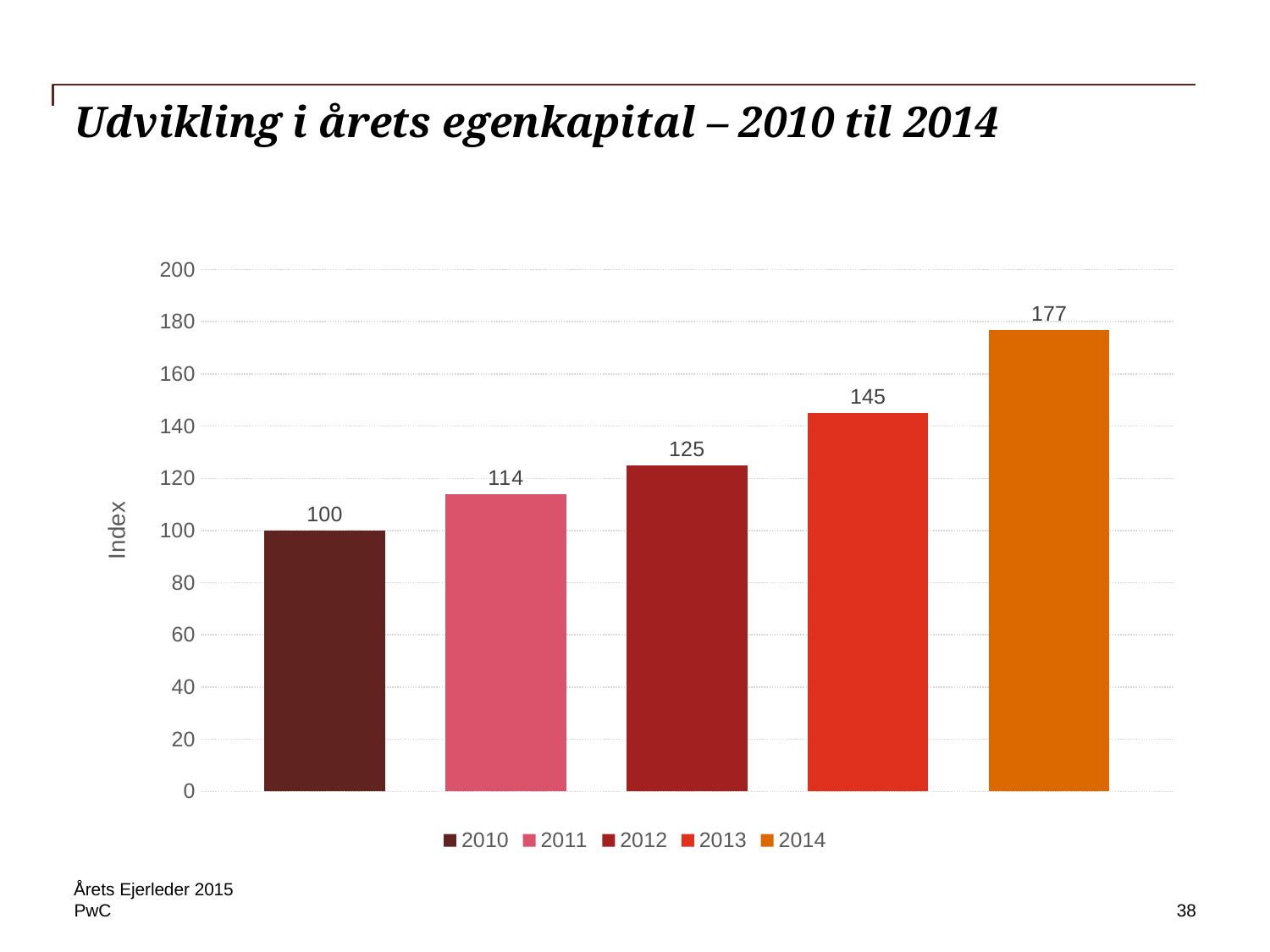
Do the index values rise or fall from 2010 to 2014? Rise What is the difference between the index values for 2014 and 2010? 77 Which is larger, the index value for 2012 or for 2011? 2012 What kind of chart is shown on the slide? Bar chart How many entries does the legend list? 5 What is the index value for 2011? 114 Which year has the highest index value? 2014 What is the index value for 2013? 145 What is the index value for 2014? 177 How many bars are shown in the chart? 5 Which year has the lowest index value? 2010 What is the difference between the index values for 2013 and 2012? 20